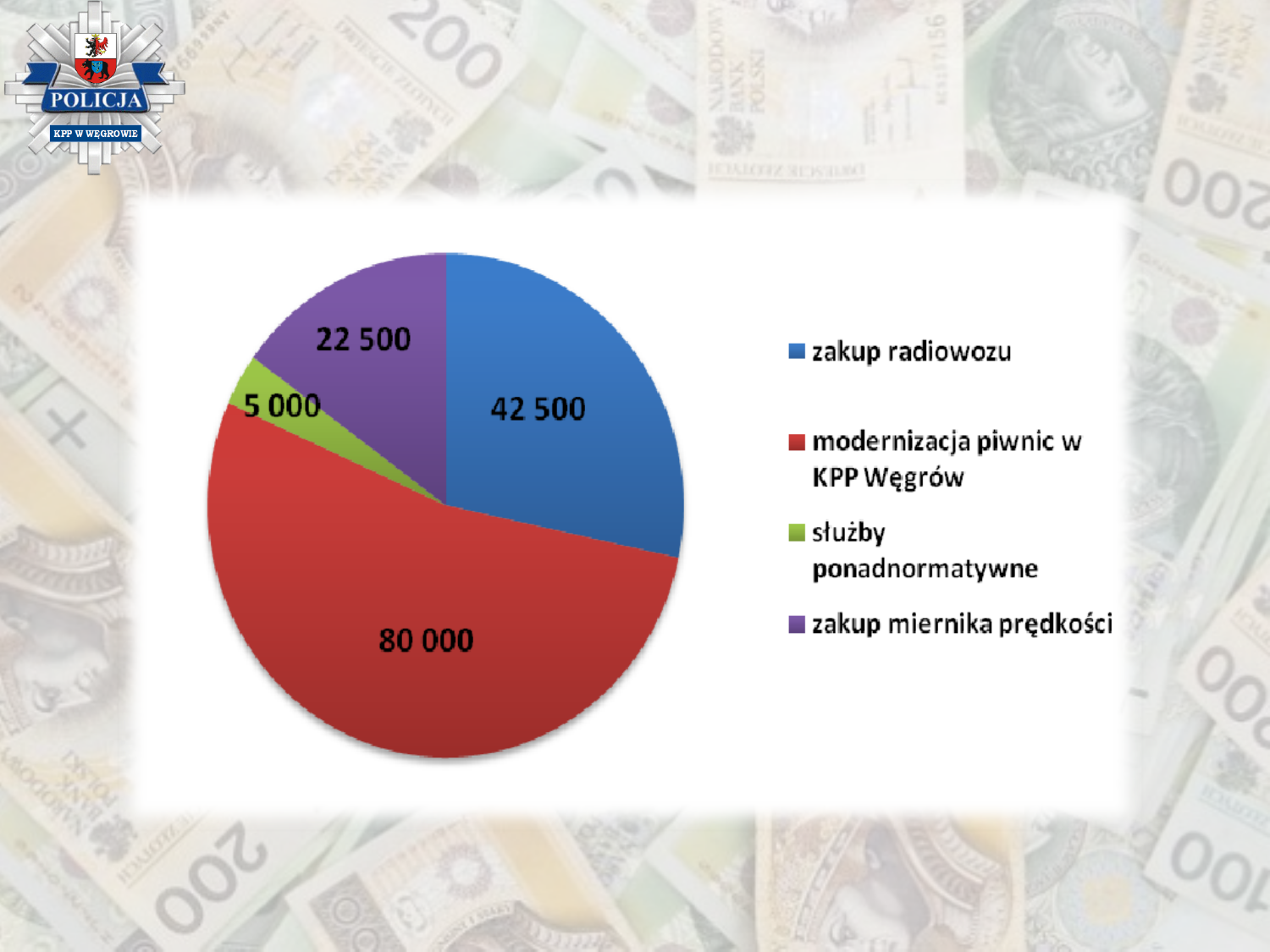
How many slices does the pie chart have? 4 What colour is the slice for służby ponadnormatywne? green Which category has the smallest slice of the pie? służby ponadnormatywne Which is larger, the value for zakup radiowozu or the value for zakup miernika prędkości? zakup radiowozu What type of chart is shown on the slide? pie chart What share of the pie does zakup miernika prędkości represent? 15% What is the value for zakup miernika prędkości? 22 500 What is the difference between the values for modernizacja piwnic w KPP Węgrów and zakup radiowozu? 37 500 What is the value for modernizacja piwnic w KPP Węgrów? 80 000 What is the value for zakup radiowozu? 42 500 What is the value for służby ponadnormatywne? 5 000 Which category has the largest slice of the pie? modernizacja piwnic w KPP Węgrów